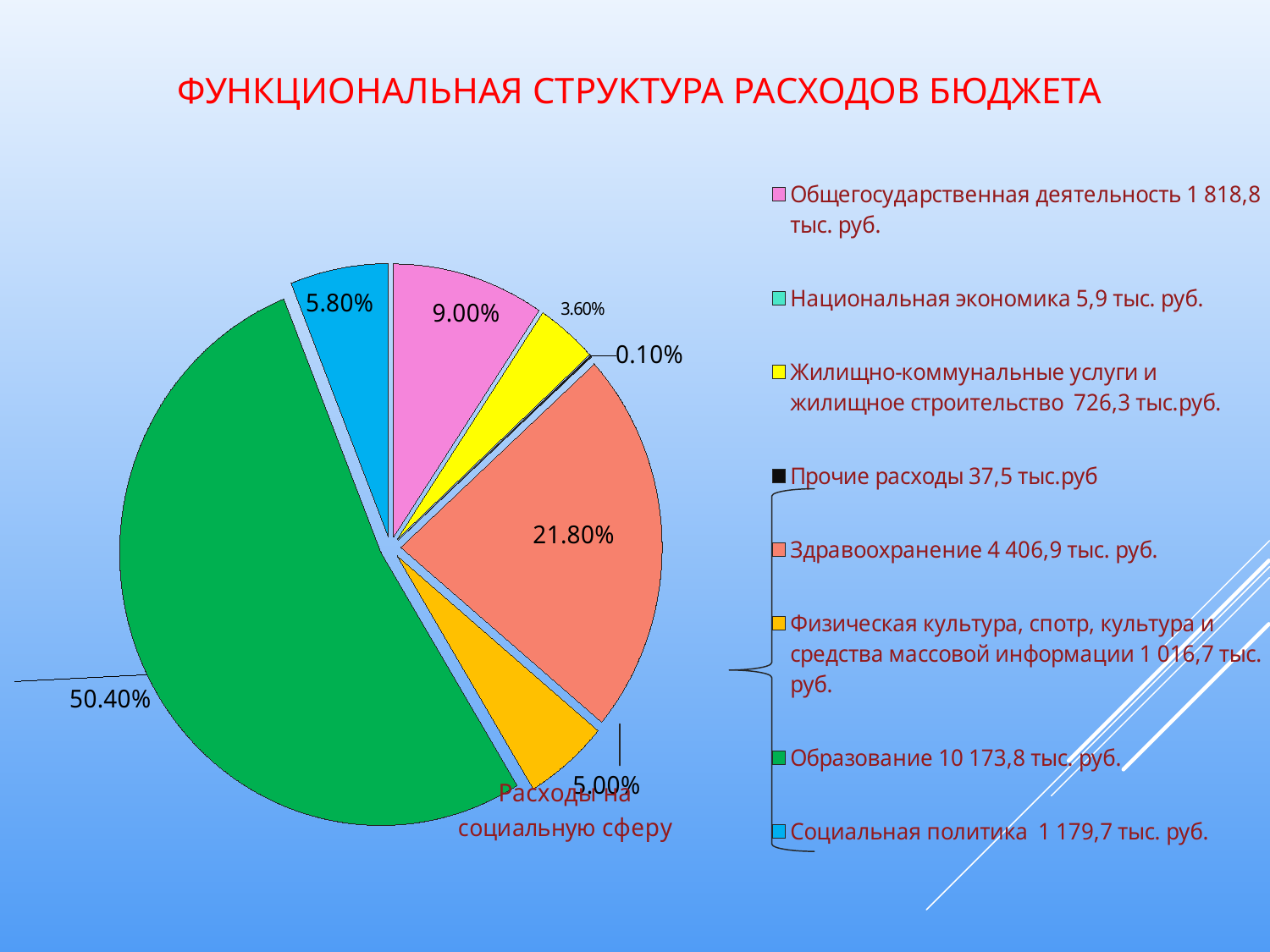
Which category has the largest share of the pie? Образование What percentage share is shown for the Общегосударственная деятельность slice? 9.00% How many categories does the legend of the pie chart list? 8 According to the legend, what amount is given for Образование? 10 173,8 тыс. руб. Which is larger: the share for Социальная политика or the share for Физическая культура, спорт, культура и средства массовой информации? Социальная политика What percentage share is shown for the Здравоохранение slice? 21.80% What percentage share is shown for the Образование slice? 50.40% What is the title of the chart on the slide? ФУНКЦИОНАЛЬНАЯ СТРУКТУРА РАСХОДОВ БЮДЖЕТА What percentage share is shown for the Социальная политика slice? 5.80% What percentage share is shown for the Жилищно-коммунальные услуги и жилищное строительство slice? 3.60% What is the difference in percentage points between the Образование share and the Здравоохранение share? 28.60% What kind of chart is shown on the slide? pie chart